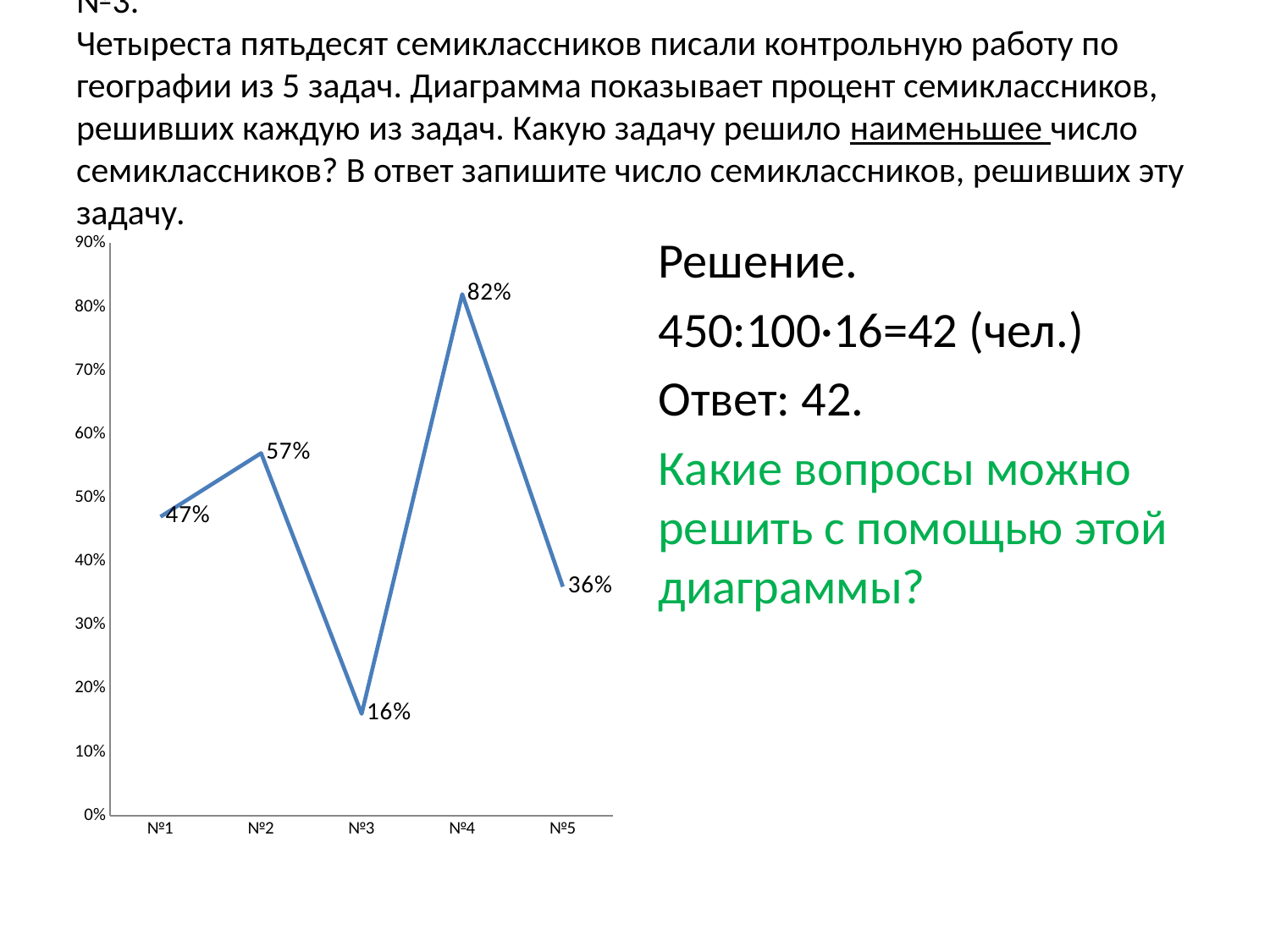
What percentage of seventh-graders solved task №1? 47% Which task was solved by the lowest percentage of seventh-graders? №3 What is the difference in percentage points between task №2 and task №1? 10 Which task was solved by the highest percentage of seventh-graders? №4 How many tasks are plotted on the chart? 5 What percentage of seventh-graders solved task №4? 82% What is the difference in percentage points between task №4 and task №3? 66 Which task has a higher percentage, №2 or №5? №2 What percentage of seventh-graders solved task №5? 36% Does the percentage rise or fall from task №4 to task №5? fall What type of chart is shown on the slide? line chart What percentage of seventh-graders solved task №3? 16%